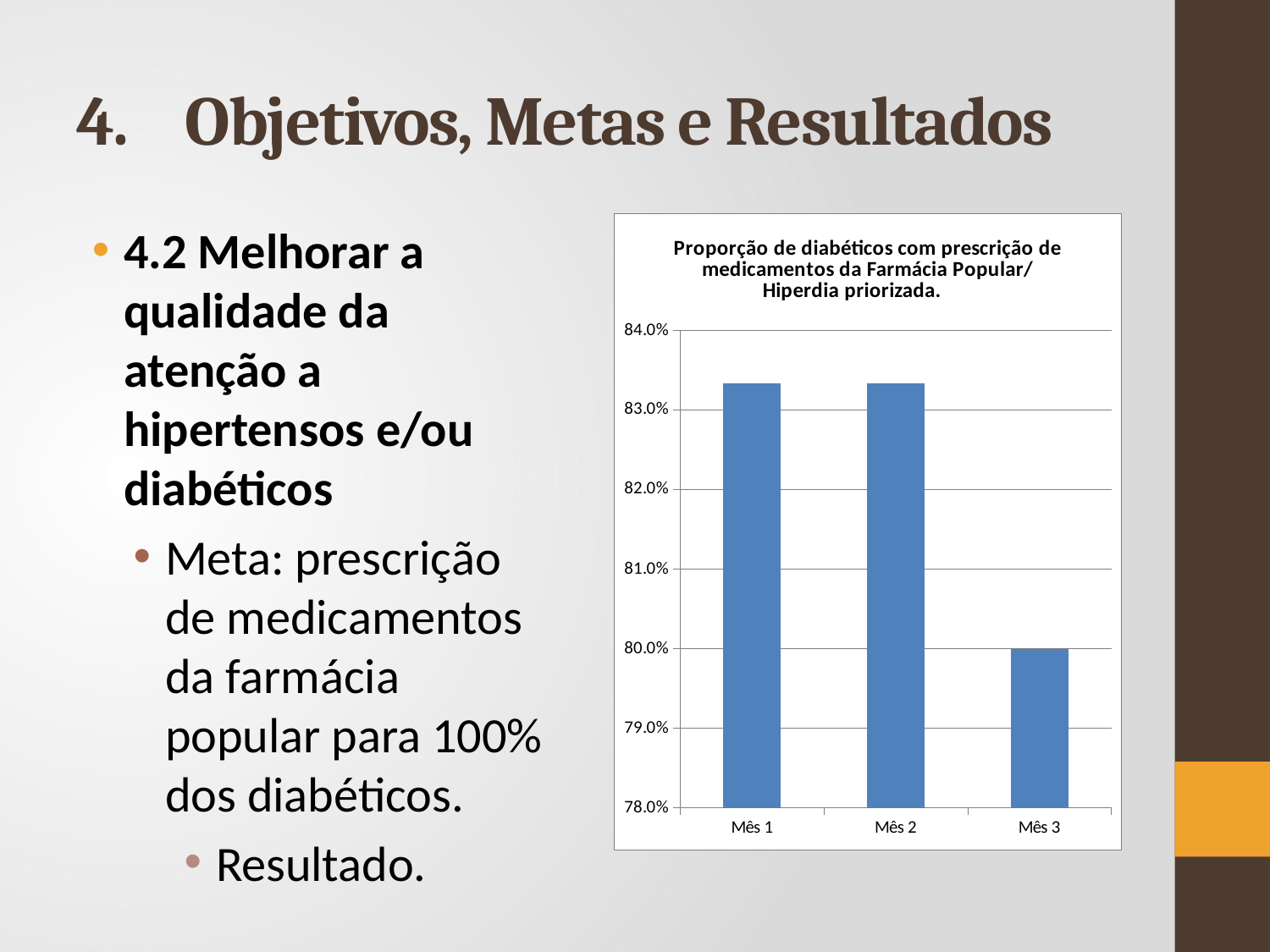
Do the values rise or fall from Mês 2 to Mês 3? fall Is the value for Mês 2 greater or less than 82.0%? greater Which is larger, the value for Mês 2 or the value for Mês 3? Mês 2 What is the value for Mês 3? 80.0% How many categories (months) are plotted on the chart? 3 What is the highest value shown on the vertical axis of the chart? 84.0% Which is larger, the value for Mês 1 or the value for Mês 3? Mês 1 Is the value for Mês 3 greater or less than 81.0%? less Is the value for Mês 1 greater or less than 83.0%? greater What kind of chart is shown on the slide? bar chart What is the title of the chart? Proporção de diabéticos com prescrição de medicamentos da Farmácia Popular/ Hiperdia priorizada. Which month has the lowest value? Mês 3